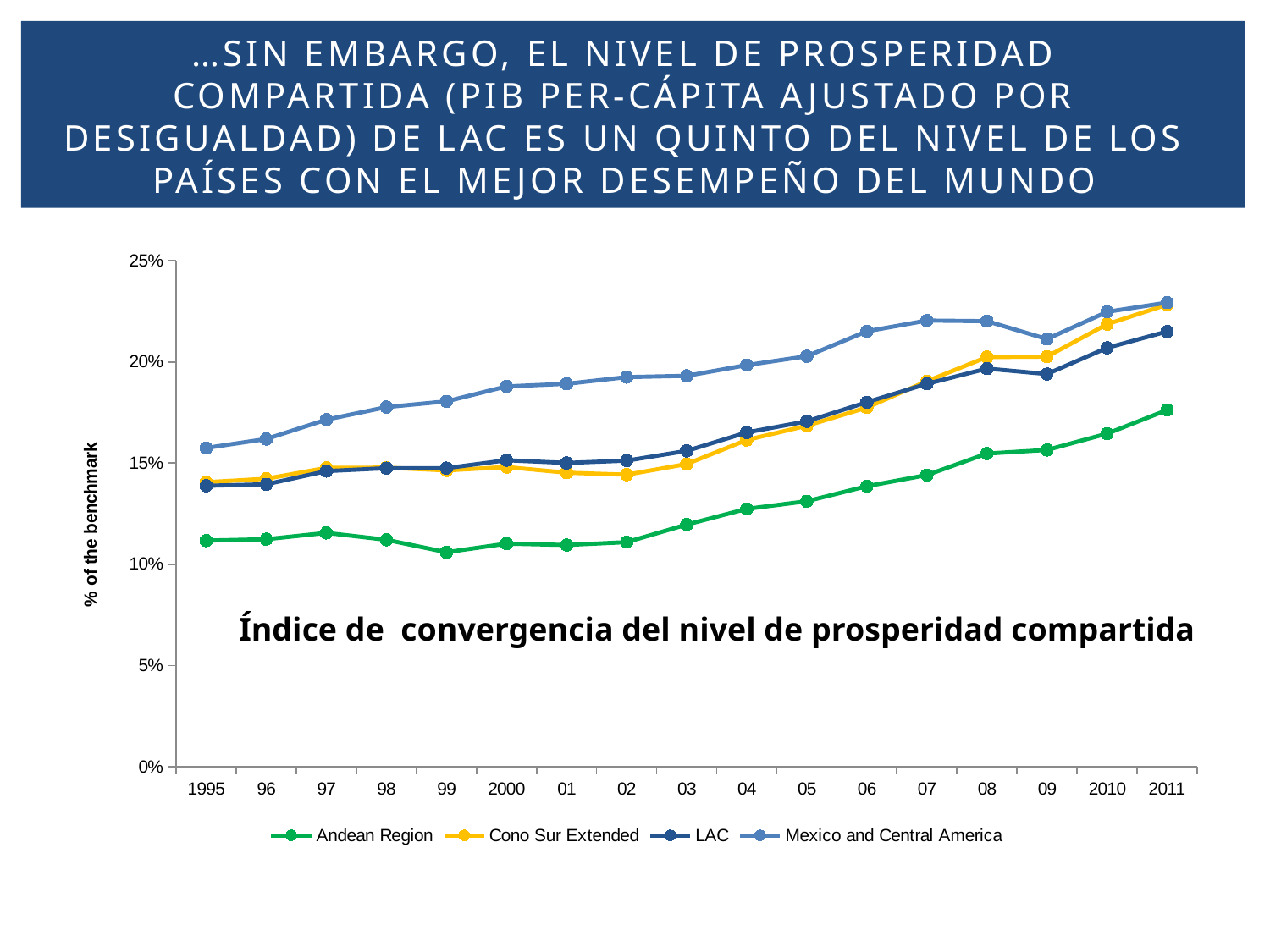
How many series does the legend list? 4 Which series has the lowest values across the whole period? Andean Region Is the value for LAC in 1995 greater or less than 15%? less Does the Andean Region series rise or fall between 2003 and 2011? rise In 2005, which is larger: the value for Mexico and Central America or the value for Andean Region? Mexico and Central America Is the value for Mexico and Central America in 2007 greater or less than 20%? greater Is the value for Andean Region in 2011 greater or less than 15%? greater What kind of chart is shown on the slide? line chart How many years are plotted along the x axis? 17 Which series has the highest value in 1995? Mexico and Central America What is the label on the y axis? % of the benchmark